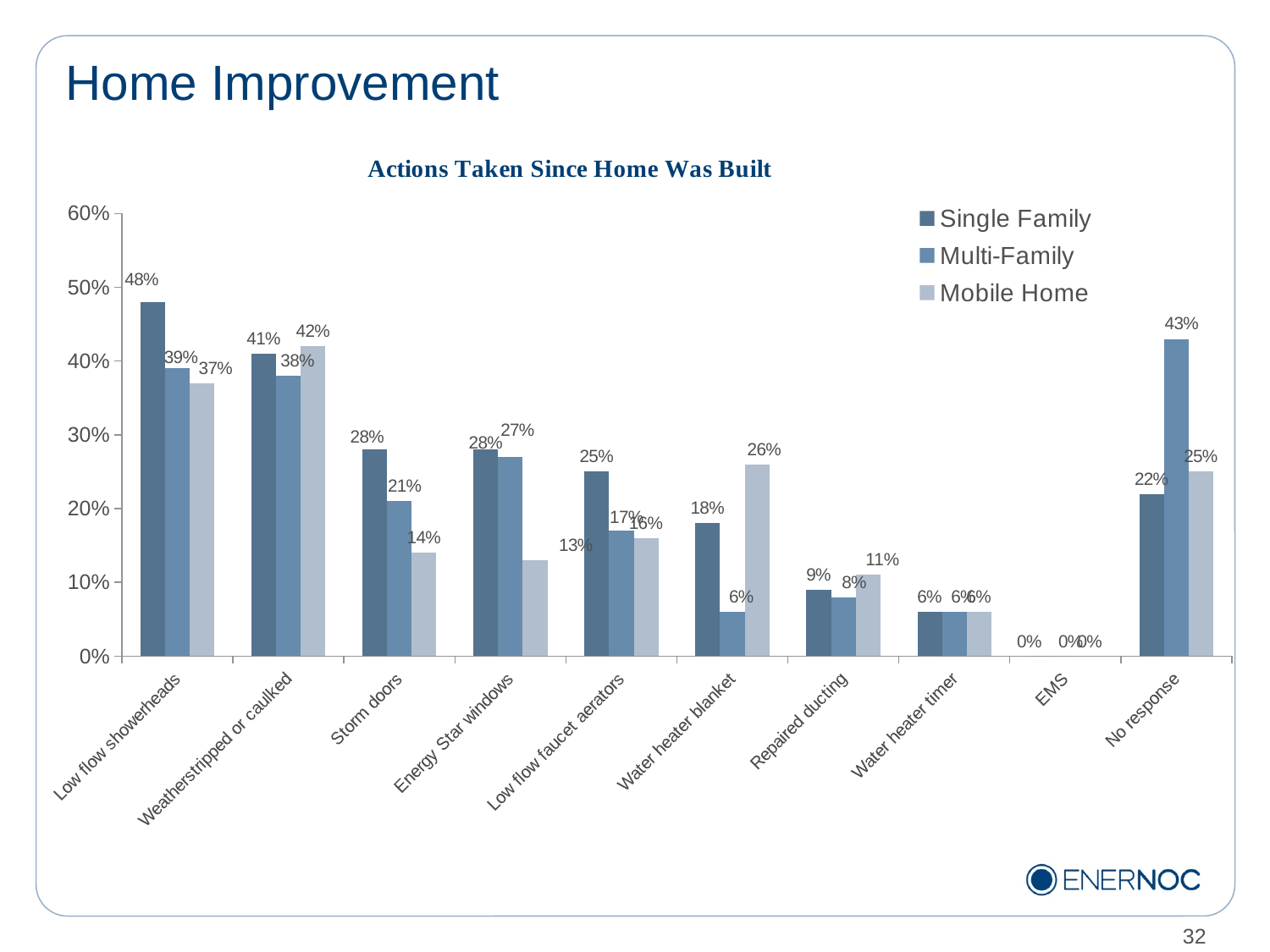
Which is larger for Water heater blanket: the Single Family value or the Mobile Home value? Mobile Home What is the Mobile Home value for Water heater blanket? 26% Which category has the highest Single Family value? Low flow showerheads How many categories are shown on the x axis? 10 How many series does the legend list? 3 What kind of chart is shown? Bar chart What is the Multi-Family value for No response? 43% What is the Single Family value for Low flow showerheads? 48% What is the title of the chart? Actions Taken Since Home Was Built What is the Multi-Family value for Energy Star windows? 27% Which category has the highest Mobile Home value? Weatherstripped or caulked What is the difference between the Single Family and Mobile Home values for Storm doors? 14%